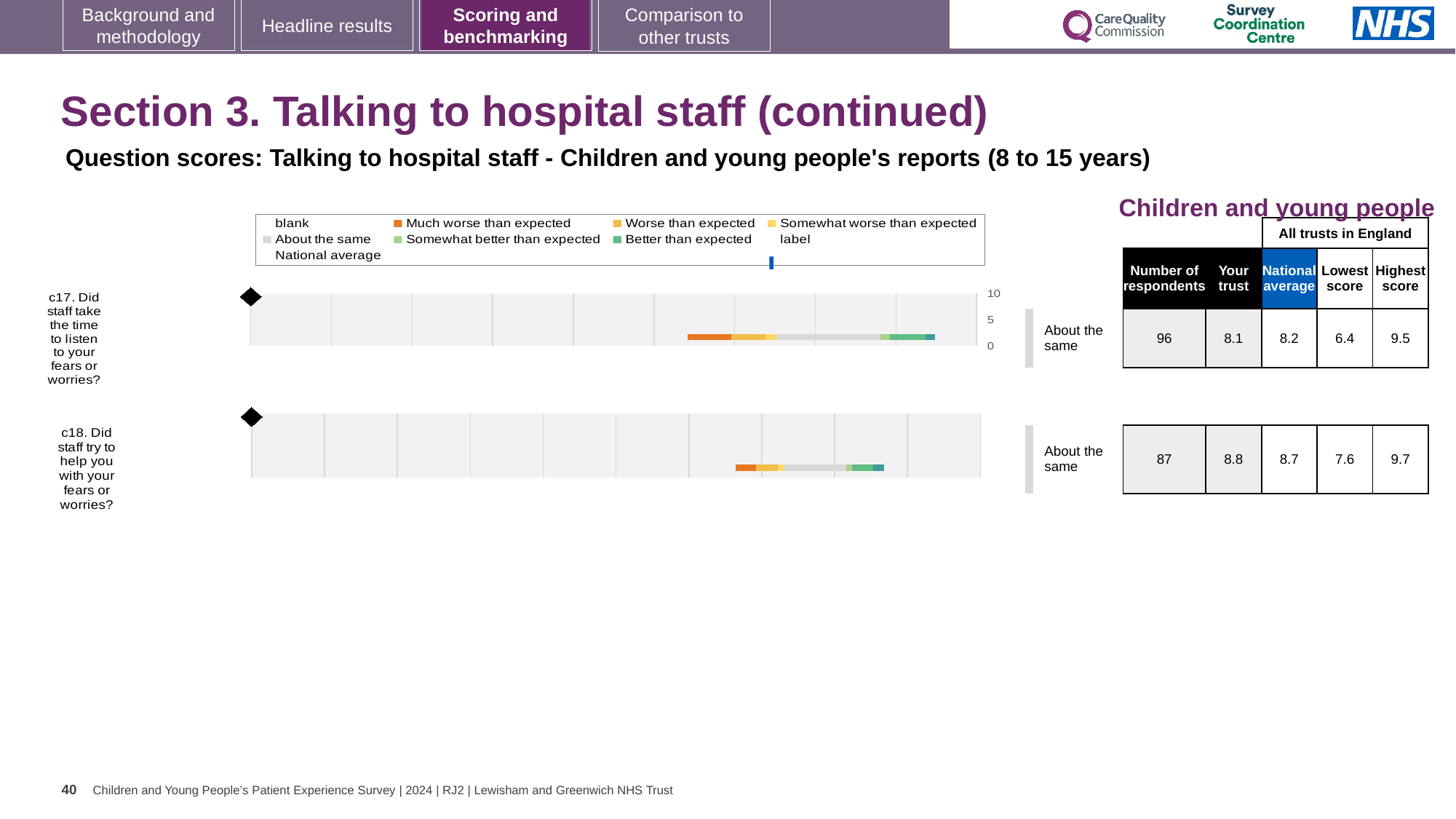
What colour represents 'Much worse than expected' in the chart legend? orange How many questions (categories) are plotted on the slide? 2 What is the national average score for question c17? 8.2 What is the 'Your trust' score for question c18 (Did staff try to help you with your fears or worries?)? 8.8 What is the 'Your trust' score for question c17 (Did staff take the time to listen to your fears or worries?)? 8.1 What is the number of respondents for question c18? 87 What benchmark rating is shown next to the chart for question c17? About the same What is the highest score among all trusts in England for question c18? 9.7 What kind of chart is used to show the benchmarking results for questions c17 and c18? bar chart What is the difference in the number of respondents between c17 and c18? 9 What is the difference between the 'Your trust' scores for c18 and c17? 0.7 Which question has the higher 'Your trust' score, c17 or c18? c18